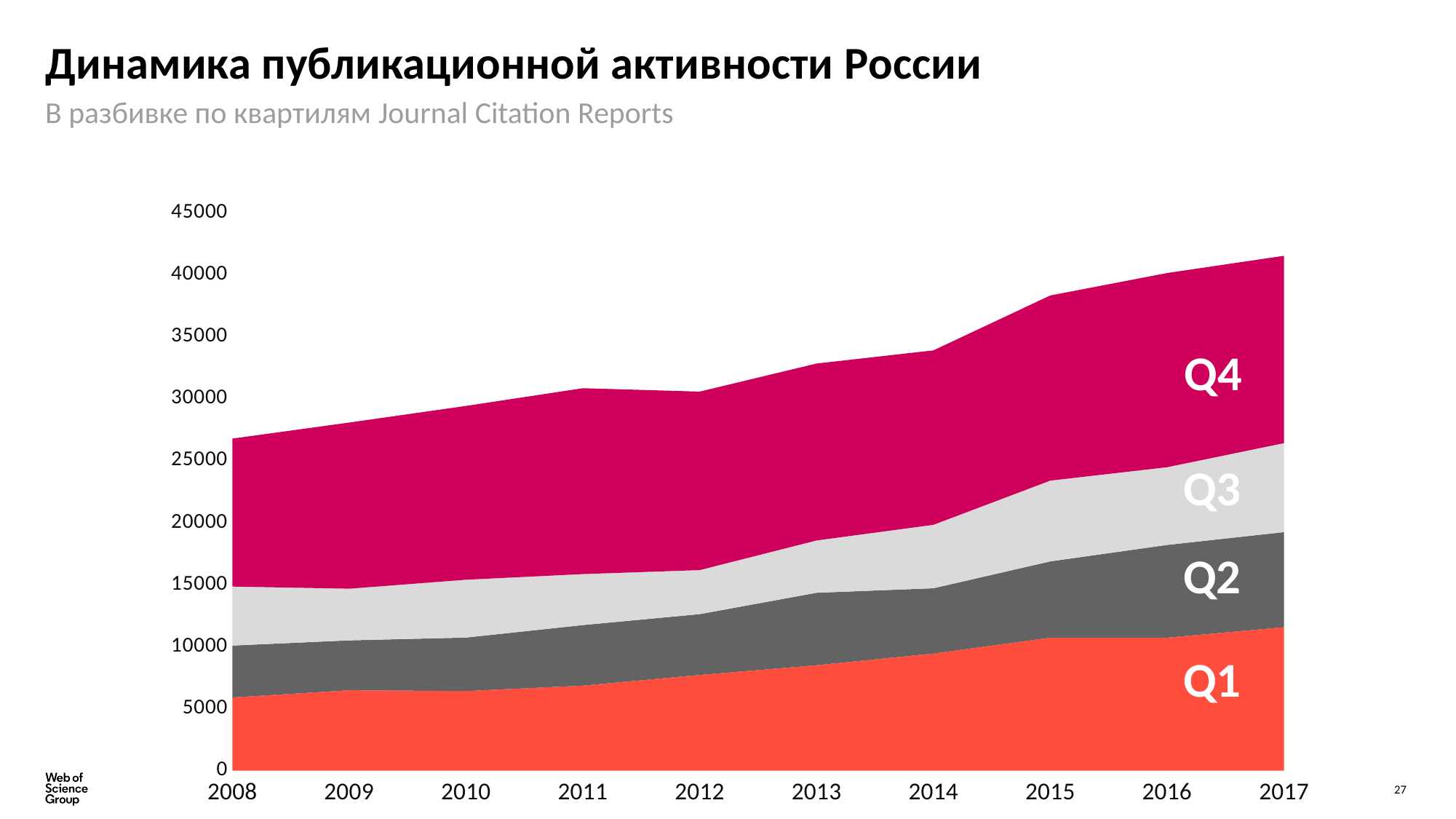
In which year is the total stacked value highest? 2017 What is the title of the slide containing the chart? Динамика публикационной активности России Which quartile series is plotted at the bottom of the stack? Q1 How many years are shown along the x axis of the chart? 10 Does the total number of publications rise or fall from 2008 to 2017? Rises In which year is the total stacked value lowest? 2008 What kind of chart is shown on the slide? Stacked area chart Is the total stacked value for 2008 greater or less than 30000? less Is the Q1 value for 2008 greater or less than 10000? less How many series (quartiles) are plotted in the chart? 4 Is the Q1 value for 2017 greater or less than 10000? greater